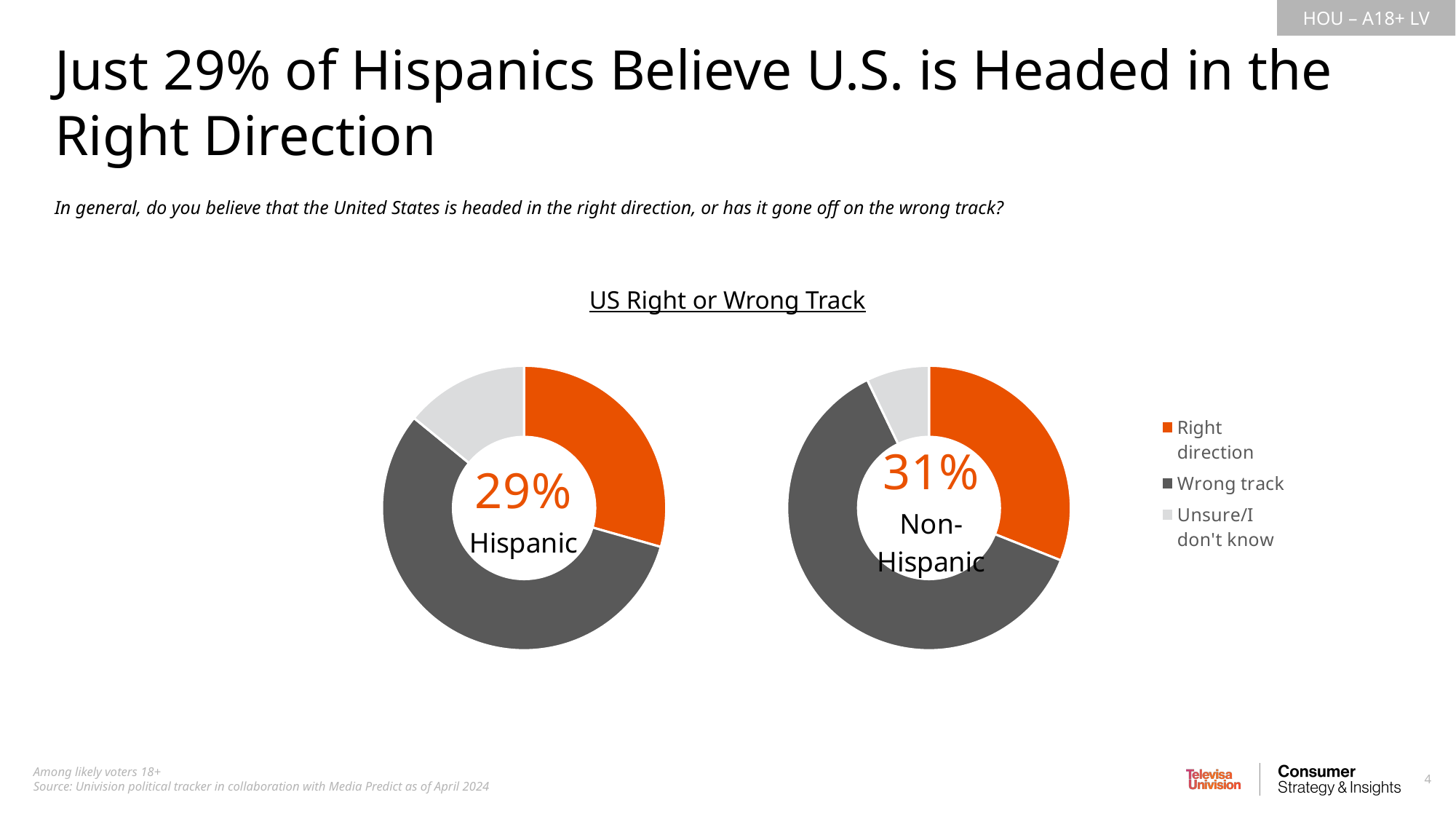
What kind of chart is used on this slide? Pie (donut) chart What is the title shown above the donut charts? US Right or Wrong Track In the Non-Hispanic donut chart, what percentage chose Right direction? 31% What is the difference in percentage points between the Non-Hispanic and Hispanic Right direction shares? 2 percentage points In the Non-Hispanic donut chart, which category has the smallest slice? Unsure/I don't know How many donut charts are shown on the slide? 2 Which group has the larger Right direction share, Hispanic or Non-Hispanic? Non-Hispanic How many categories does the legend list? 3 In the Hispanic donut chart, what percentage chose Right direction? 29% In the Hispanic donut chart, which category has the largest slice? Wrong track In the Non-Hispanic donut chart, which category has the largest slice? Wrong track In the Hispanic donut chart, which category has the smallest slice? Unsure/I don't know